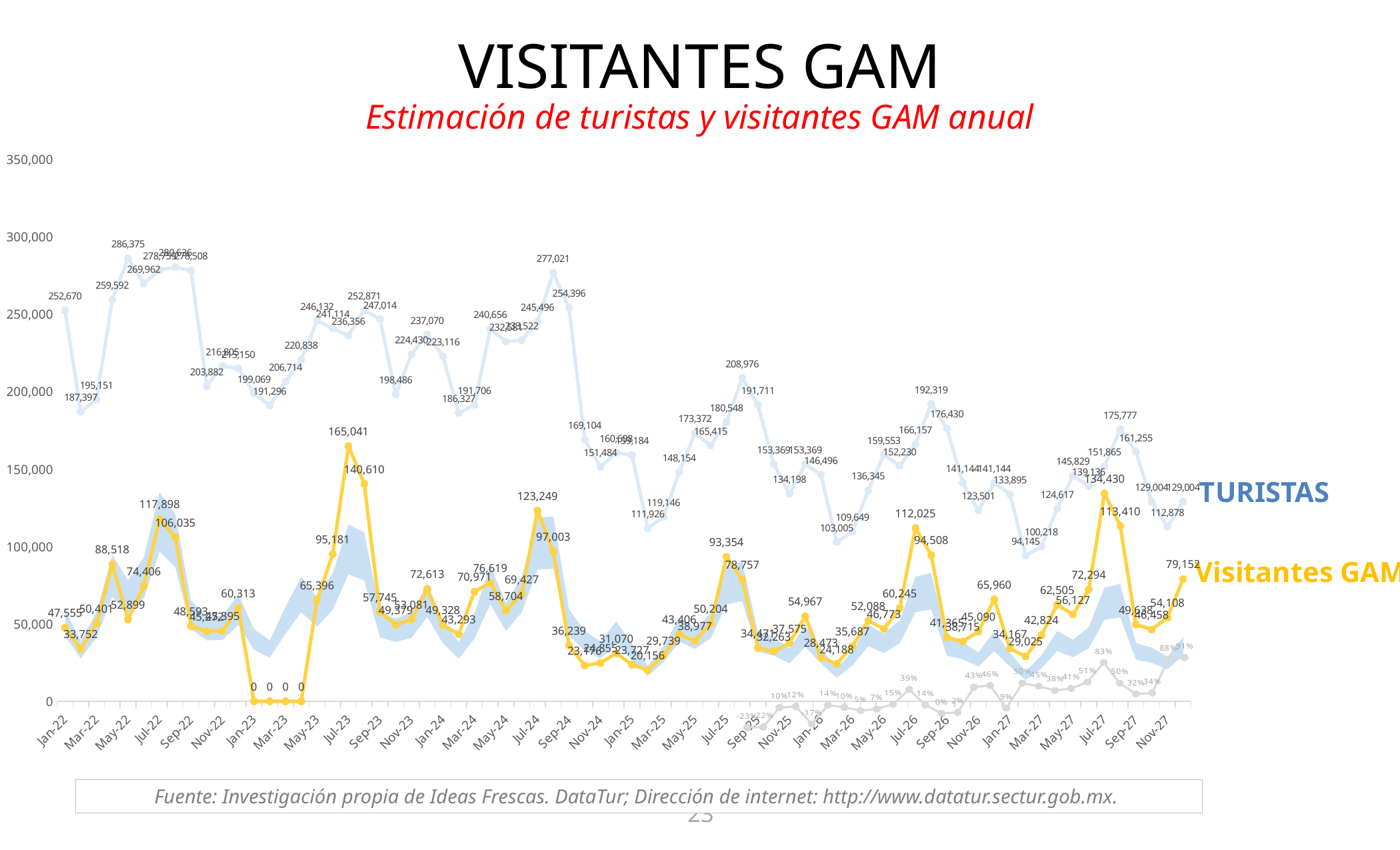
What is the Visitantes GAM value for Jan-23? 0 What is the Visitantes GAM value for Jul-23? 165,041 Is the TURISTAS value for Jul-24 greater or less than 250,000? less What kind of chart is shown on the slide? line chart What is the difference between the Visitantes GAM values for Jul-23 (165,041) and Aug-23 (140,610)? 24,431 Which month has the larger Visitantes GAM value, Jul-24 or Jul-25? Jul-24 What is the highest value reached by the Visitantes GAM series? 165,041 What is the highest value reached by the TURISTAS series? 286,375 What is the TURISTAS value for Jan-22? 252,670 What is the TURISTAS value for Jul-25? 180,548 Which series is drawn in yellow? Visitantes GAM